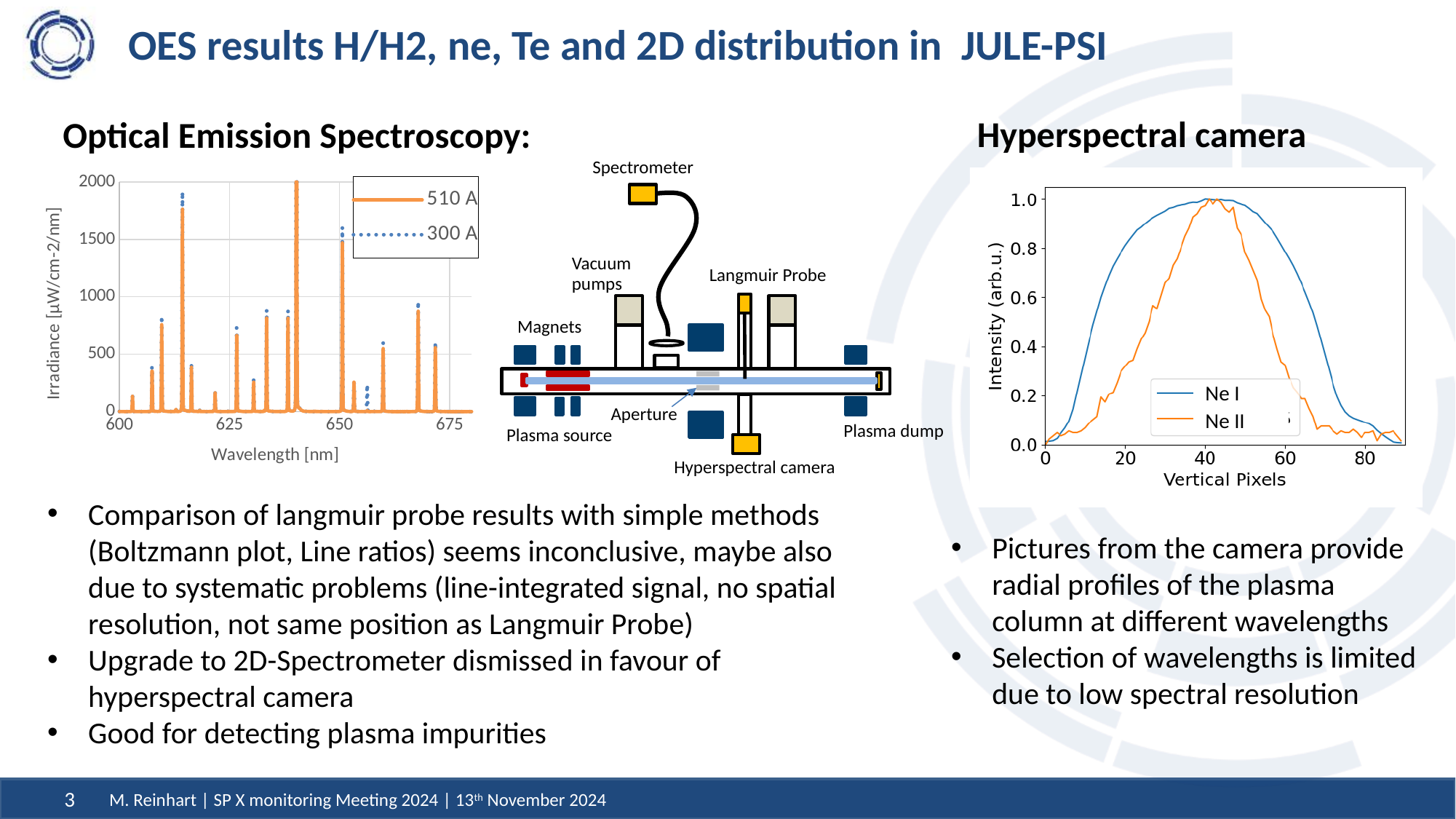
In the Hyperspectral camera chart on the right, what is the x-axis label? Vertical Pixels In the Optical Emission Spectroscopy chart on the left, what are the two series named in the legend? 510 A and 300 A In the Optical Emission Spectroscopy chart on the left, how many series does the legend list? 2 What is the x-axis label of the Optical Emission Spectroscopy chart on the left? Wavelength [nm] In the Optical Emission Spectroscopy chart on the left, is the 510 A peak near 615 nm greater or less than 1500? greater In the Hyperspectral camera chart on the right, which series has the larger intensity at vertical pixel 20, Ne I or Ne II? Ne I In the Optical Emission Spectroscopy chart on the left, is the small 510 A peak near 605 nm greater or less than 500? less In the Hyperspectral camera chart on the right, is the Ne II intensity at vertical pixel 20 greater or less than 0.4? less What kind of chart is the Hyperspectral camera chart on the right? line chart In the Hyperspectral camera chart on the right, how many series does the legend list? 2 In the Optical Emission Spectroscopy chart on the left, what is the highest value shown on the y axis? 2000